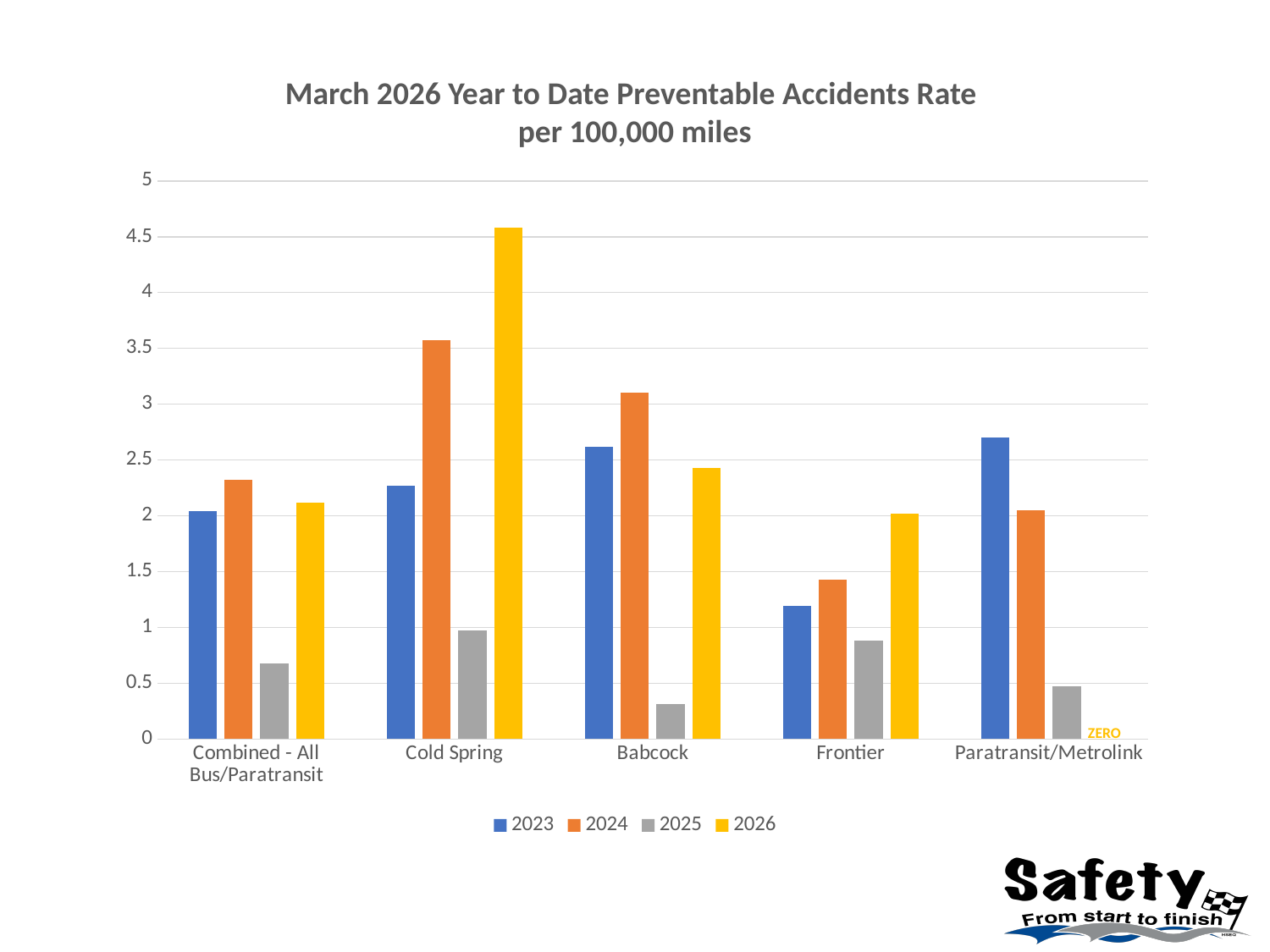
How many categories are shown on the x axis? 5 Which category has the highest 2024 value? Cold Spring What is the 2026 value for Paratransit/Metrolink? ZERO Which category has the lowest 2024 value? Frontier What is the title of the chart? March 2026 Year to Date Preventable Accidents Rate per 100,000 miles How many series does the legend list? 4 Which category has the highest 2026 value? Cold Spring Is the 2026 value for Cold Spring greater or less than 4? greater Is the 2023 value for Paratransit/Metrolink greater or less than 2.5? greater What kind of chart is shown on the slide? bar chart For Babcock, which is larger: the 2023 value or the 2024 value? 2024 Is the 2025 value for Babcock greater or less than 0.5? less